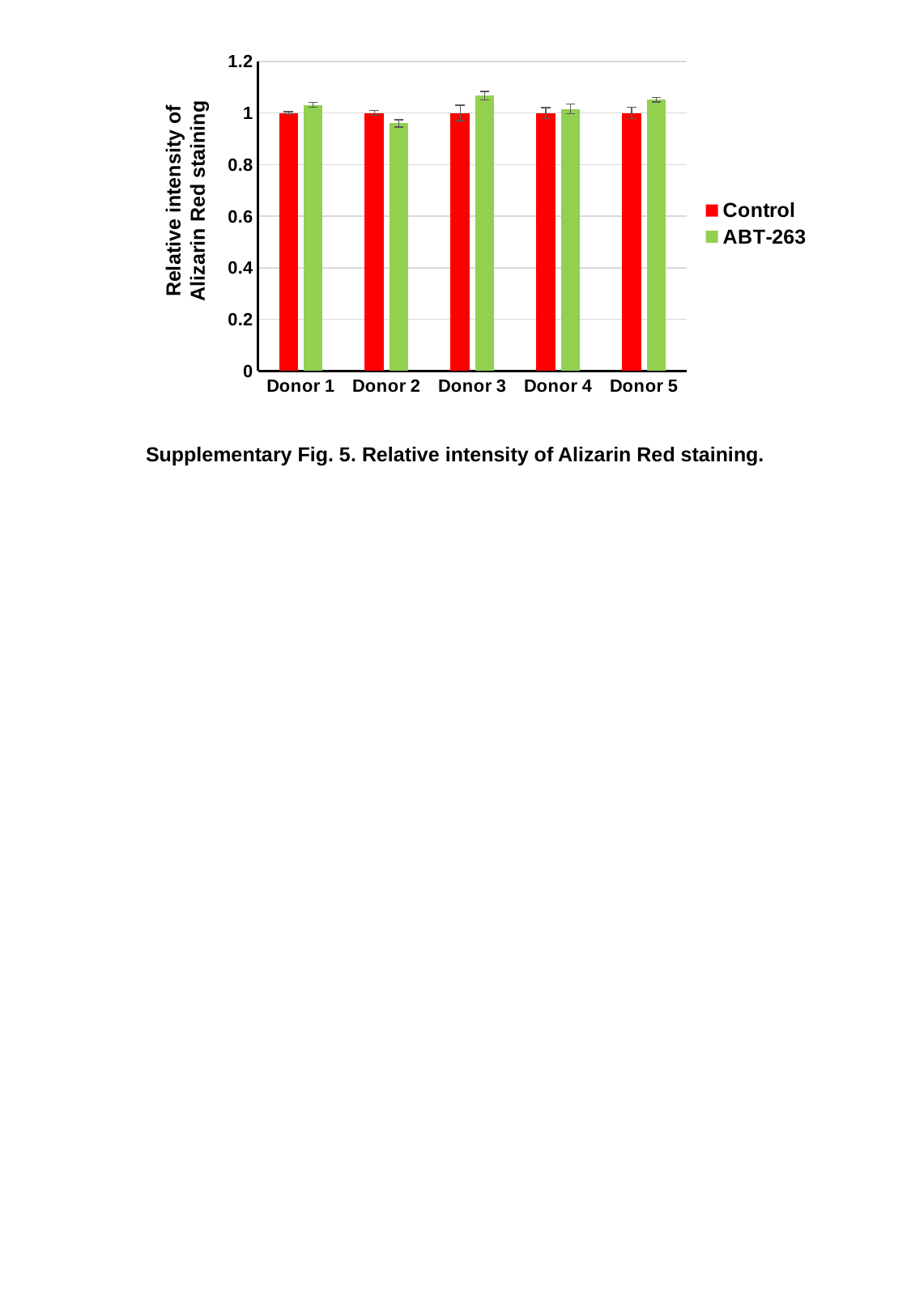
Is the ABT-263 value for Donor 2 greater or less than 1? less How many series does the chart legend list? 2 How many donors are shown on the x axis of the chart? 5 What is the value of the Control bar for Donor 4? 1 What kind of chart is shown on the slide? bar chart Is the ABT-263 value for Donor 5 greater or less than 1? greater Is the ABT-263 value for Donor 3 greater or less than 1? greater Which donor has the lowest ABT-263 value? Donor 2 What colour are the ABT-263 bars in the chart? green For Donor 3, which is larger, the Control bar or the ABT-263 bar? ABT-263 For Donor 2, which is larger, the Control bar or the ABT-263 bar? Control What is the value of the Control bar for Donor 1? 1